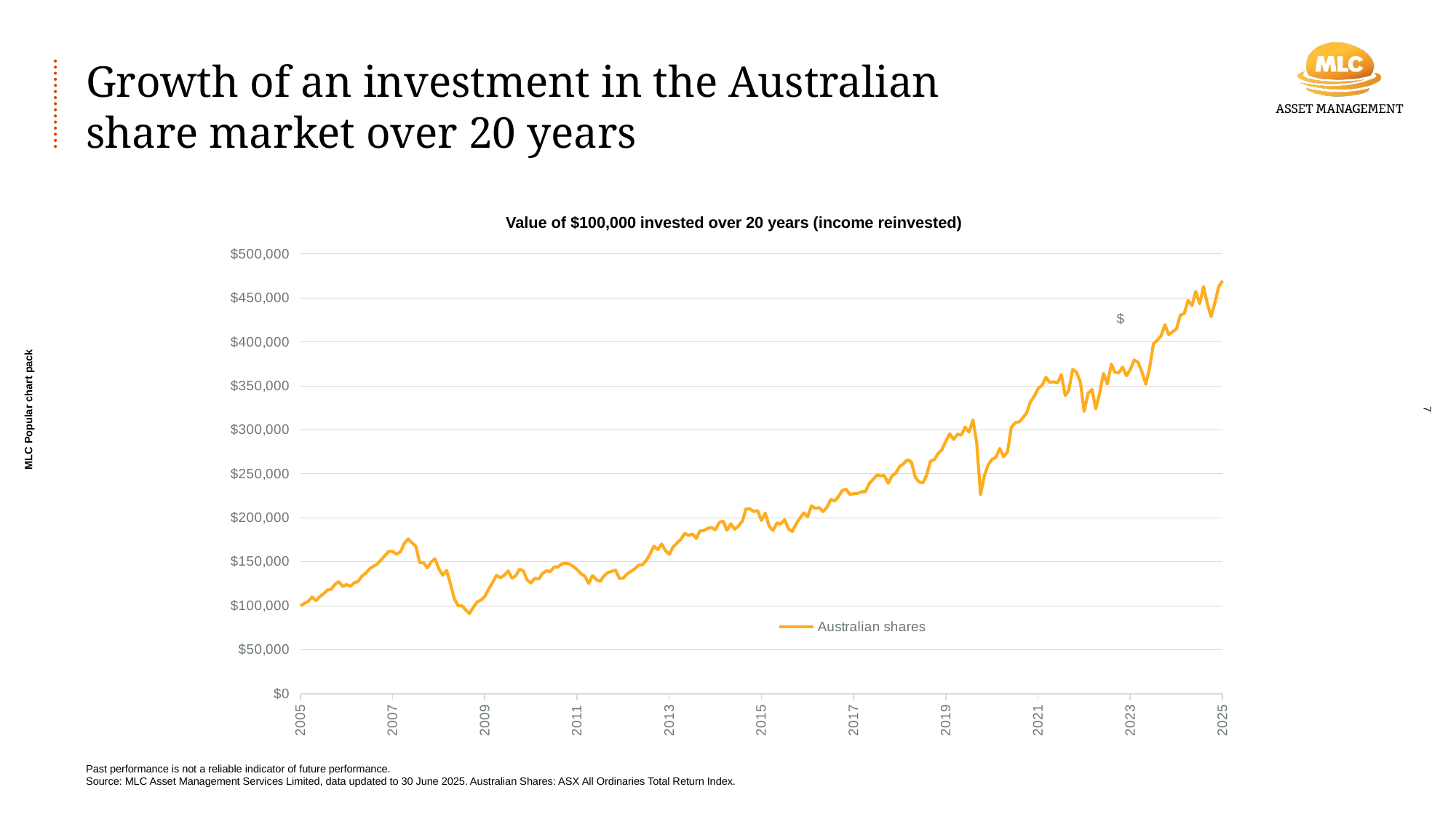
How many series does the legend list? 1 Overall, does the value of the investment rise or fall from 2005 to 2025? rise Is the value of the investment at 2025 greater or less than $450,000? greater Is the value of the investment at 2013 greater or less than $150,000? greater What is the name of the series shown in the legend? Australian shares In which year shown on the x axis does the investment reach its highest value? 2025 What kind of chart is shown on the slide? line chart Is the value of the investment at 2009 greater or less than $150,000? less What is the value of the investment at the start of the chart in 2005? $100,000 What is the title of the chart? Value of $100,000 invested over 20 years (income reinvested) Which year has the higher investment value, 2007 or 2009? 2007